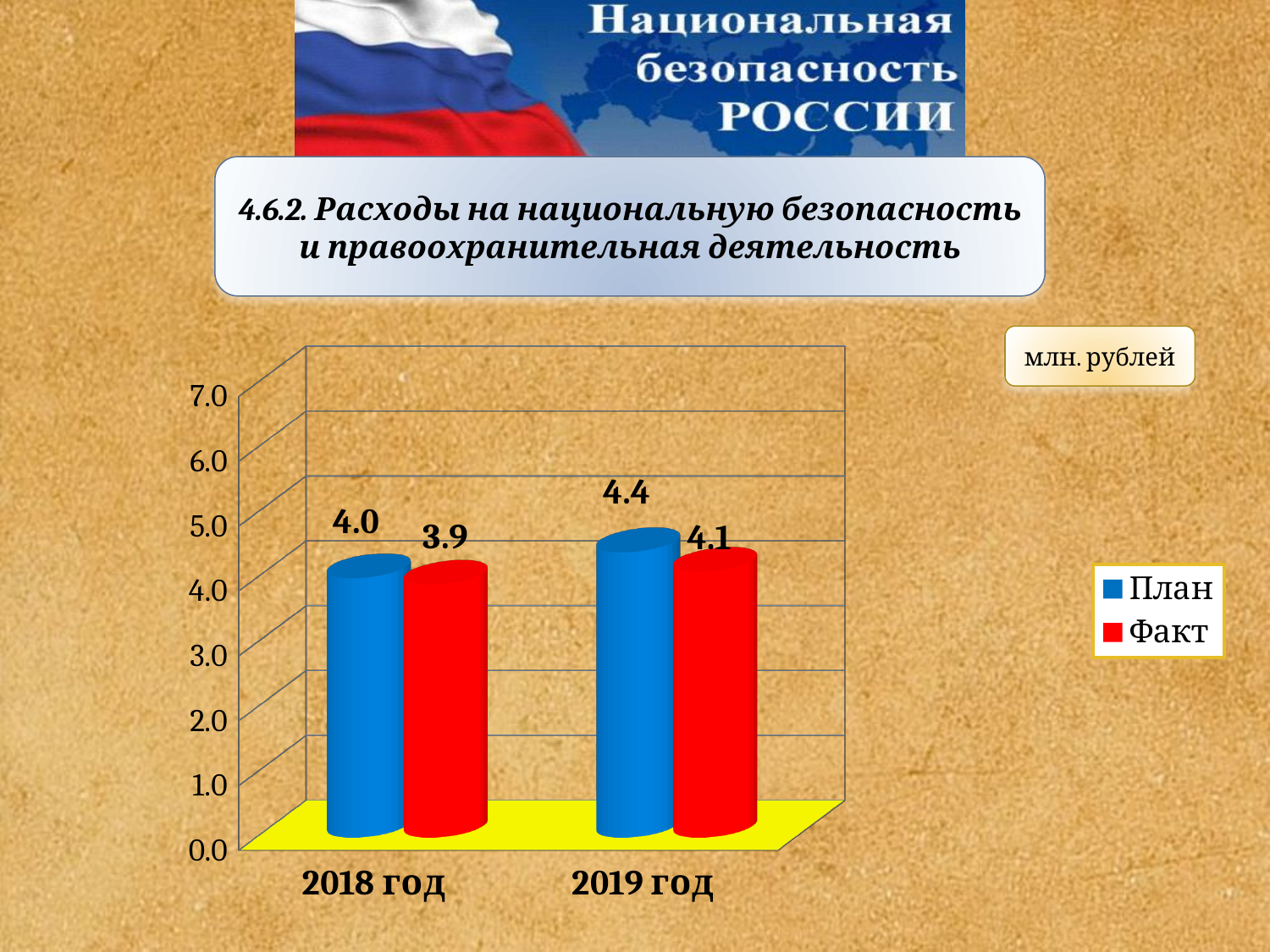
Which is larger for 2018 год, План or Факт? План What is the Факт value for 2019 год? 4.1 Which year has the highest План value? 2019 год Which year has the lowest Факт value? 2018 год How many series does the legend list? 2 What is the Факт value for 2018 год? 3.9 What is the План value for 2019 год? 4.4 What is the План value for 2018 год? 4.0 What unit is indicated for the chart values? млн. рублей How many years are shown on the x axis? 2 What is the difference between the План and Факт values for 2019 год? 0.3 What kind of chart is shown on the slide? Bar chart